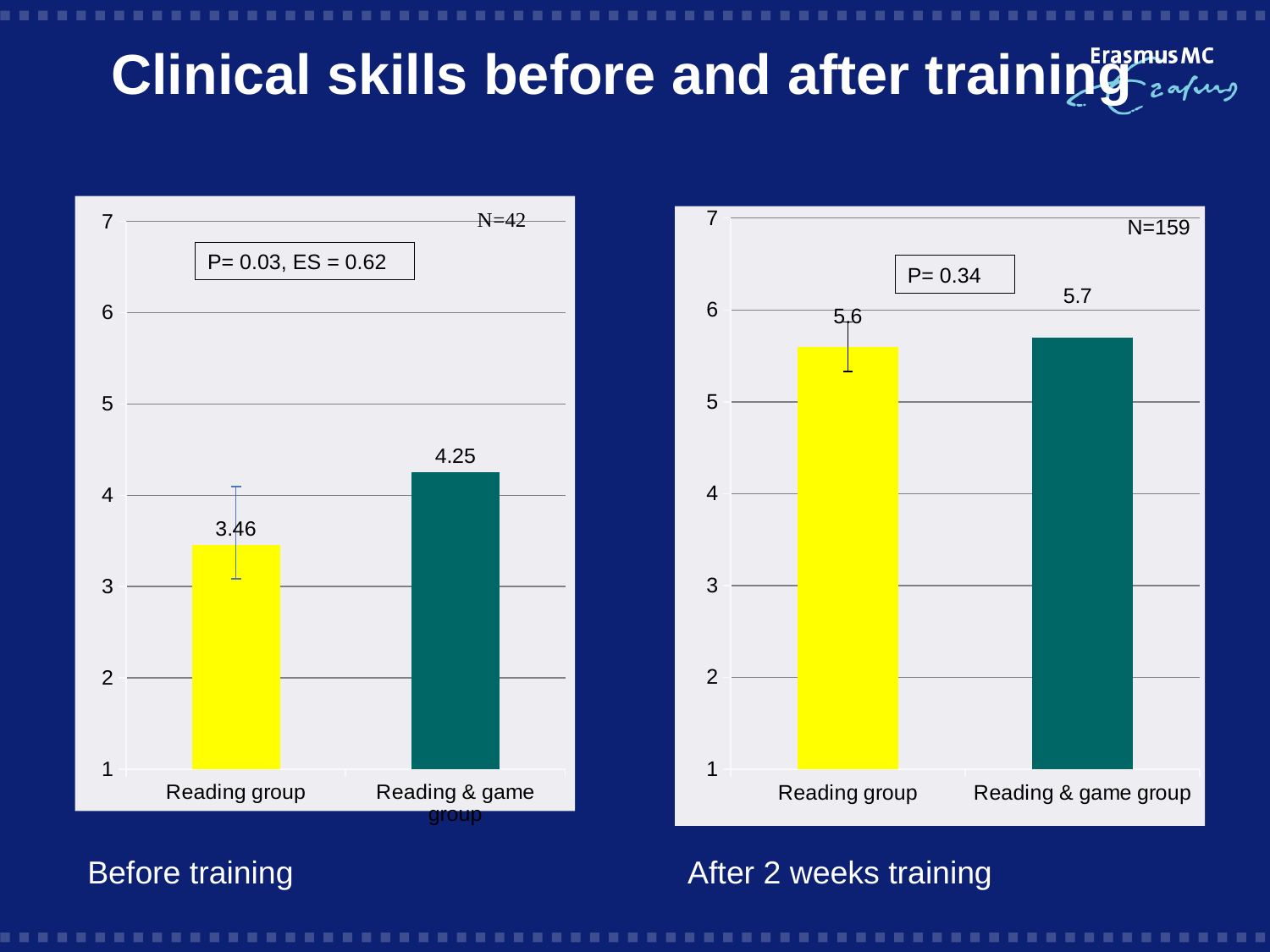
In the 'After 2 weeks training' chart on the right, what is the difference between the Reading & game group and the Reading group? 0.1 In the 'After 2 weeks training' chart on the right, what is the value for the Reading & game group? 5.7 In the 'Before training' chart on the left, is the value for the Reading group greater or less than 4? less How many bars are shown in the 'After 2 weeks training' chart on the right? 2 What type of chart is the 'Before training' chart on the left? Bar chart What sample size (N) is shown on the 'After 2 weeks training' chart on the right? N=159 In the 'After 2 weeks training' chart on the right, what is the value for the Reading group? 5.6 In the 'After 2 weeks training' chart on the right, is the value for the Reading & game group greater or less than 5? greater In the 'Before training' chart on the left, which group has the higher value? Reading & game group In the 'Before training' chart on the left, what is the difference between the Reading & game group and the Reading group? 0.79 In the 'Before training' chart on the left, what is the value for the Reading & game group? 4.25 In the 'Before training' chart on the left, what is the value for the Reading group? 3.46